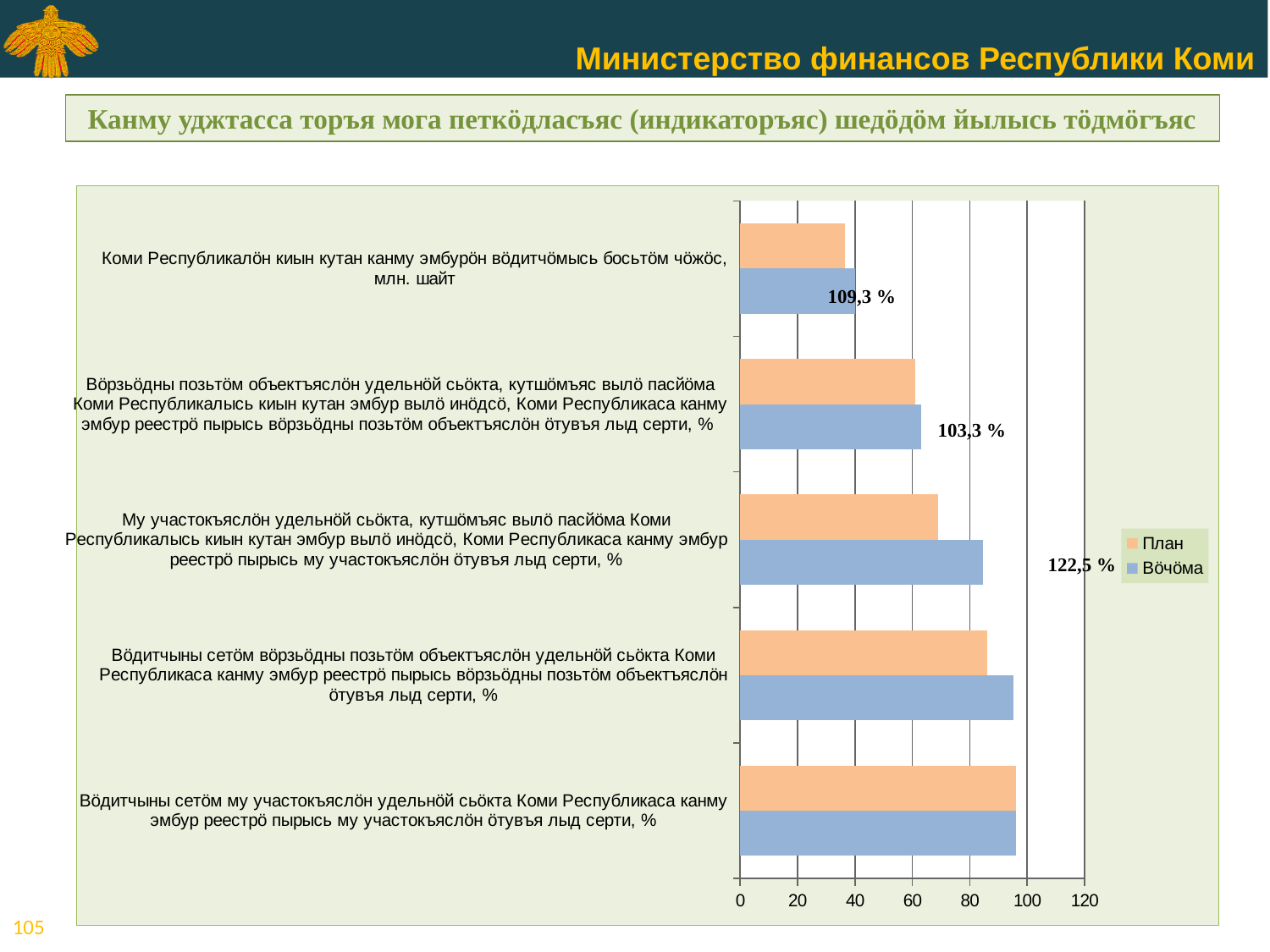
How many categories are plotted on the chart? 5 How many series does the legend list? 2 Which category has the lowest План value? Коми Республикалöн киын кутан канму эмбурöн вöдитчöмысь босьтöм чöжöс, млн. шайт Is the План value for the top category ("...млн. шайт") greater or less than 40? less What kind of chart is shown on the slide? bar chart What percentage label is printed next to the second category from the top ("Вöрзьöдны позьтöм объектъяслöн удельнöй сьöкта...")? 103,3 % For the middle category ("Му участокъяслöн удельнöй сьöкта..."), which series has the larger bar, План or Вöчöма? Вöчöма What are the two series named in the legend? План and Вöчöма Is the План value for the second category from the top ("Вöрзьöдны позьтöм объектъяслöн...") greater or less than 80? less Is the Вöчöма value for the middle category ("Му участокъяслöн удельнöй сьöкта...") greater or less than 80? greater What percentage label is printed next to the top category ("...босьтöм чöжöс, млн. шайт")? 109,3 % What percentage label is printed next to the middle category ("Му участокъяслöн удельнöй сьöкта...")? 122,5 %